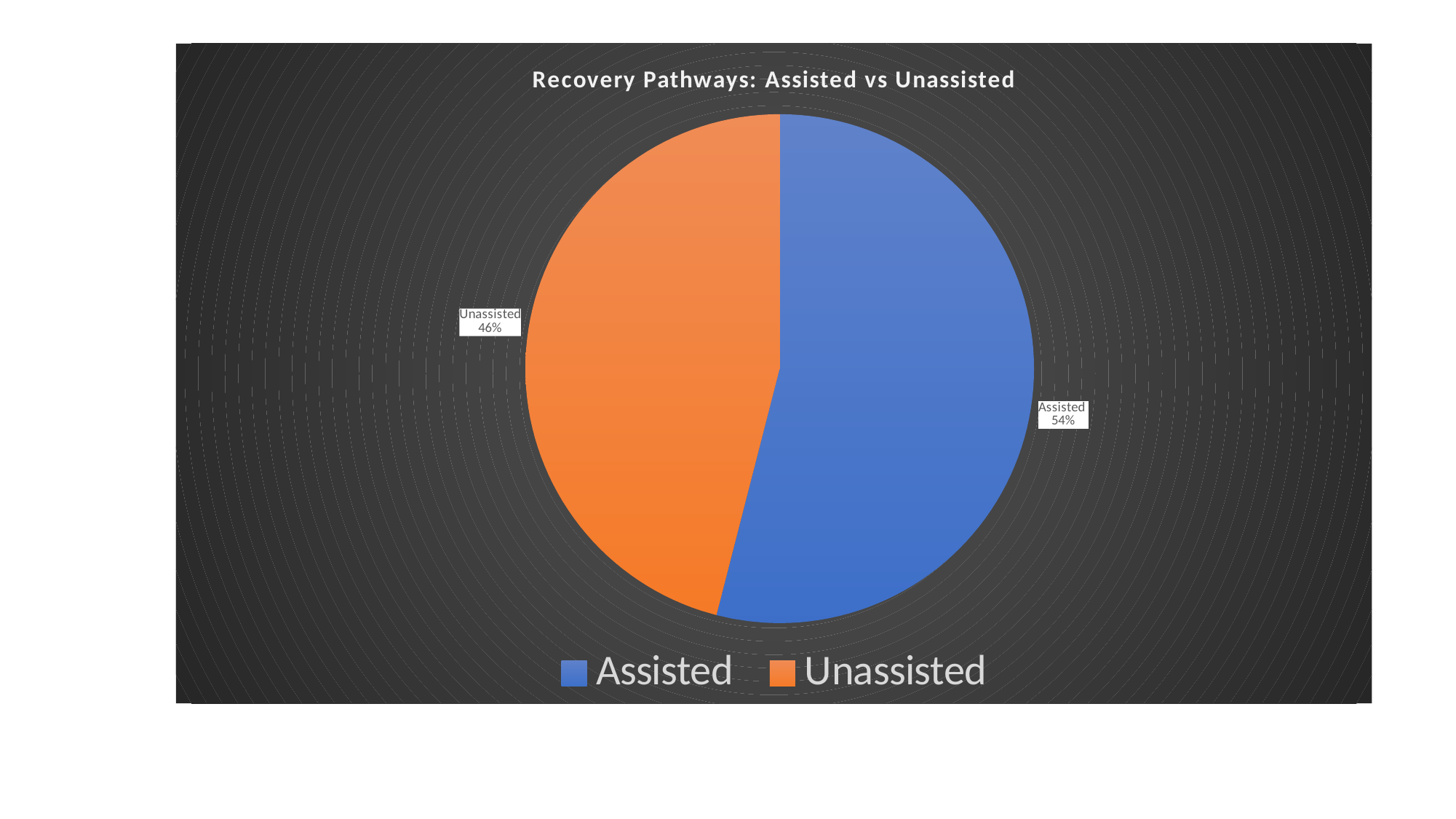
Which slice is the largest? Assisted What is the title of the chart? Recovery Pathways: Assisted vs Unassisted How many entries does the legend list? 2 What kind of chart is shown on the slide? Pie chart Which slice is the smallest? Unassisted How many slices does the pie chart have? 2 Which is larger, Assisted or Unassisted? Assisted What share of the pie does Assisted represent? 54% What is the difference in percentage points between Assisted and Unassisted? 8 What share of the pie does Unassisted represent? 46% What colour is the Unassisted slice? Orange